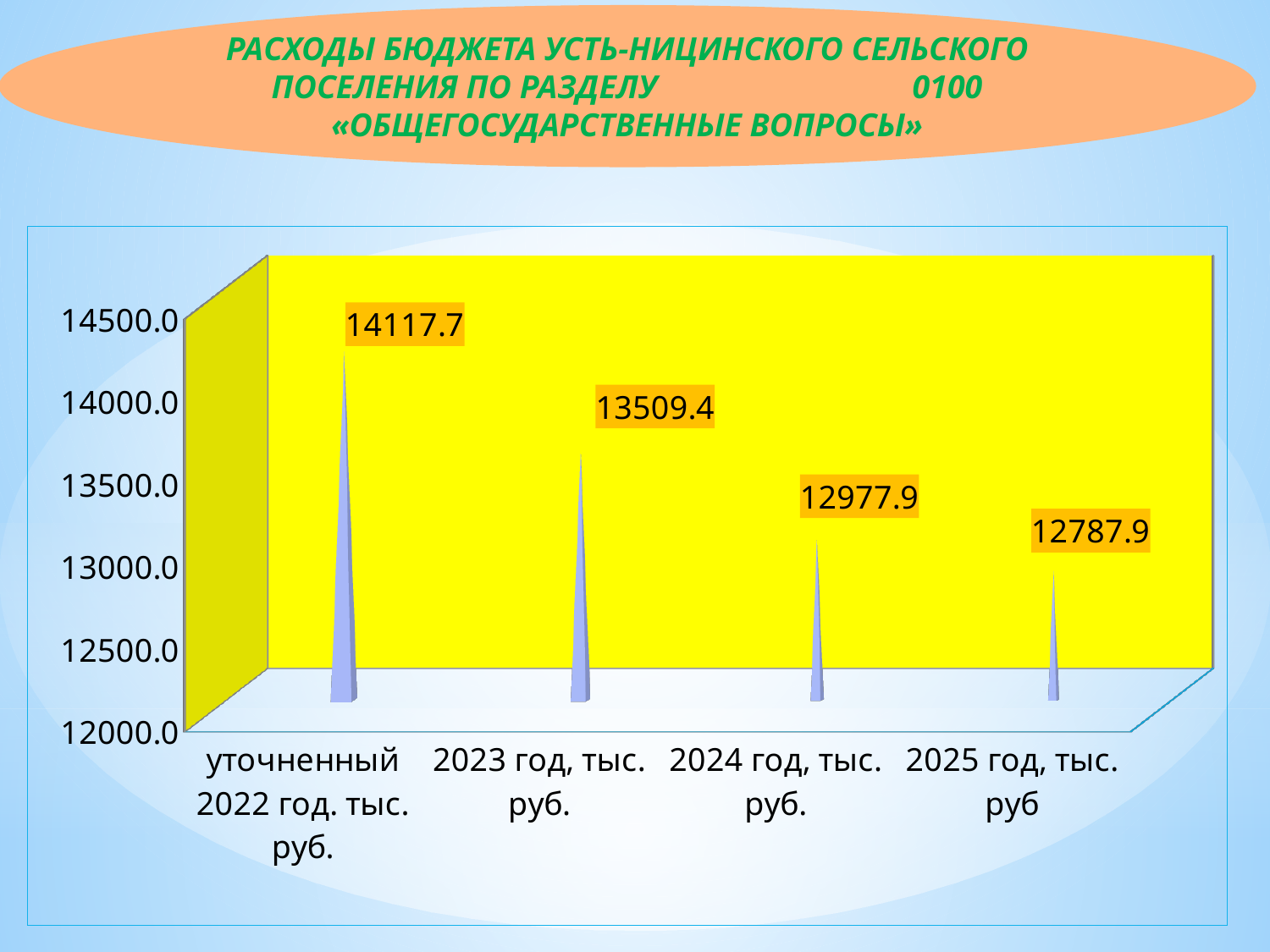
Do the values rise or fall from left to right along the x axis? fall What is the value for 2025 год, тыс. руб? 12787.9 What is the difference between the values for 2024 год and 2025 год? 190.0 Which category has the lowest value? 2025 год, тыс. руб Which category has the highest value? уточненный 2022 год. тыс. руб. Which is larger, the value for 2023 год or the value for 2024 год? 2023 год, тыс. руб. What kind of chart is shown on the slide? bar chart What is the value for 2024 год, тыс. руб.? 12977.9 What is the value for the refined 2022 year (уточненный 2022 год)? 14117.7 How many categories are shown on the x axis? 4 What is the difference between the values for уточненный 2022 год and 2023 год? 608.3 What is the value for 2023 год, тыс. руб.? 13509.4